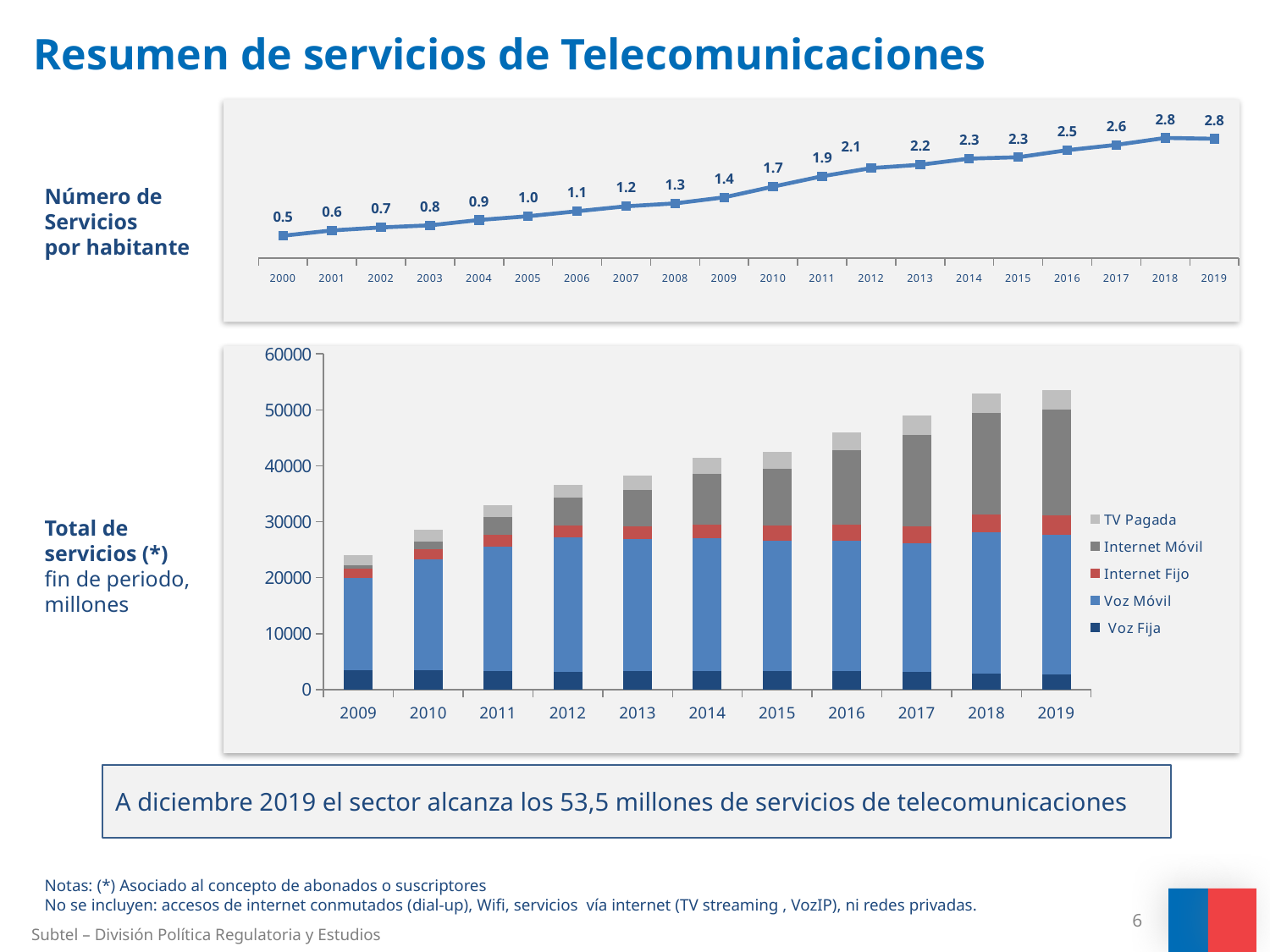
In the top chart (Número de Servicios por habitante), what is the value for 2019? 2.8 In the bottom chart (Total de servicios), how many years are shown on the x axis? 11 In the top chart (Número de Servicios por habitante), how many years are plotted? 20 In the bottom chart (Total de servicios), how many series does the legend list? 5 In the top chart (Número de Servicios por habitante), do the values rise or fall from 2000 to 2019? rise In the top chart (Número de Servicios por habitante), what is the difference between the 2019 value and the 2000 value? 2.3 In the bottom chart (Total de servicios), which year has the lowest total? 2009 In the top chart (Número de Servicios por habitante), what is the value for 2000? 0.5 In the top chart (Número de Servicios por habitante), what is the value for 2010? 1.7 In the bottom chart (Total de servicios), is the total for 2019 greater or less than 50000? greater In the top chart (Número de Servicios por habitante), which year has the lowest value? 2000 What kind of chart is the top chart (Número de Servicios por habitante)? line chart